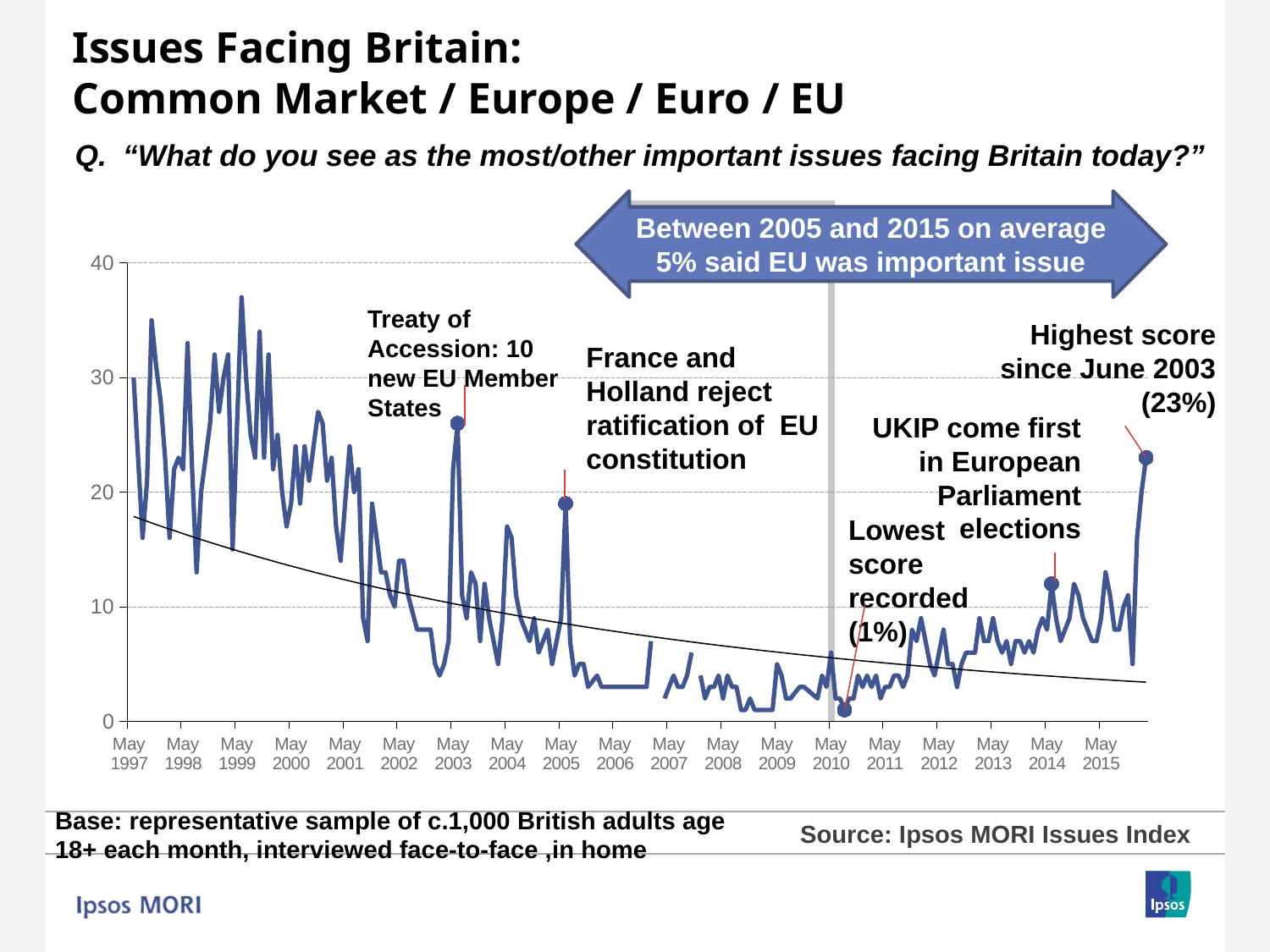
What is the highest score since June 2003, as annotated on the chart? 23% What is the difference between the highest score since June 2003 (23%) and the lowest score recorded (1%)? 22 percentage points Does the line generally rise or fall from May 1997 to May 2010? fall What is the lowest score recorded, as annotated on the chart? 1% Which peak is higher: the one at the 'Treaty of Accession' annotation or the one at the 'France and Holland reject ratification of EU constitution' annotation? Treaty of Accession What kind of chart is shown on the slide? line chart Is the peak marked by the 'Treaty of Accession' annotation greater or less than 20? greater Is the value around May 2009 greater or less than 10? less What event is annotated at the peak near May 2014? UKIP come first in European Parliament elections How many year labels are shown on the x axis? 19 According to the chart annotation, on average what percentage said the EU was an important issue between 2005 and 2015? 5% Is the value at May 1997 greater or less than 20? greater